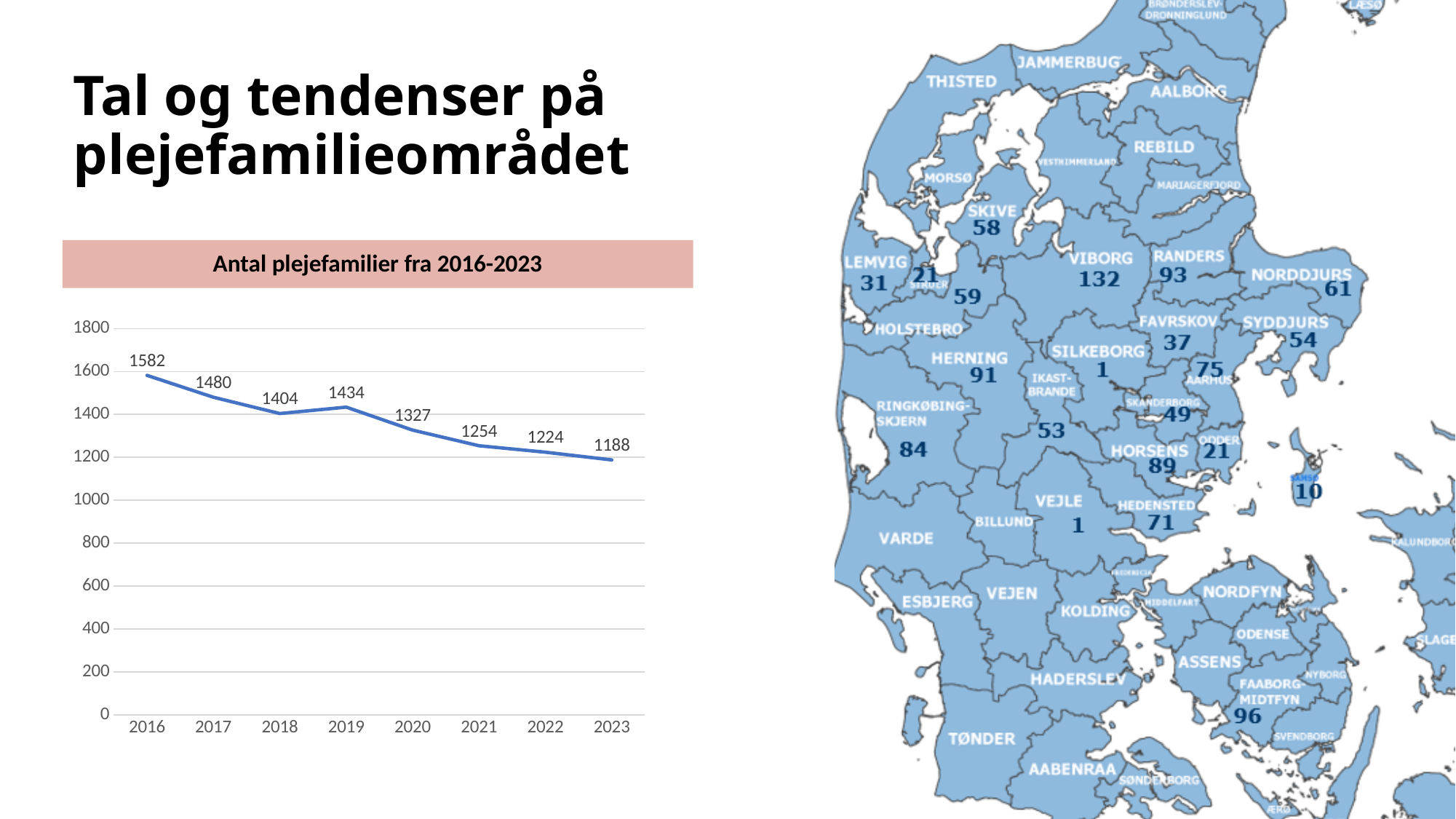
In the chart 'Antal plejefamilier fra 2016-2023', what is the value for 2016? 1582 In the chart 'Antal plejefamilier fra 2016-2023', is the value for 2020 greater or less than 1400? less What kind of chart is 'Antal plejefamilier fra 2016-2023'? line chart In the chart 'Antal plejefamilier fra 2016-2023', which year has the lowest value? 2023 In the chart 'Antal plejefamilier fra 2016-2023', which is larger, the value for 2018 or the value for 2019? 2019 In the chart 'Antal plejefamilier fra 2016-2023', what is the difference between the values for 2018 and 2019? 30 In the chart 'Antal plejefamilier fra 2016-2023', which year has the highest value? 2016 In the chart 'Antal plejefamilier fra 2016-2023', what is the difference between the values for 2016 and 2023? 394 In the chart 'Antal plejefamilier fra 2016-2023', what is the value for 2019? 1434 How many years are plotted in the chart 'Antal plejefamilier fra 2016-2023'? 8 In the chart 'Antal plejefamilier fra 2016-2023', do the values generally rise or fall from 2016 to 2023? fall In the chart 'Antal plejefamilier fra 2016-2023', what is the value for 2023? 1188